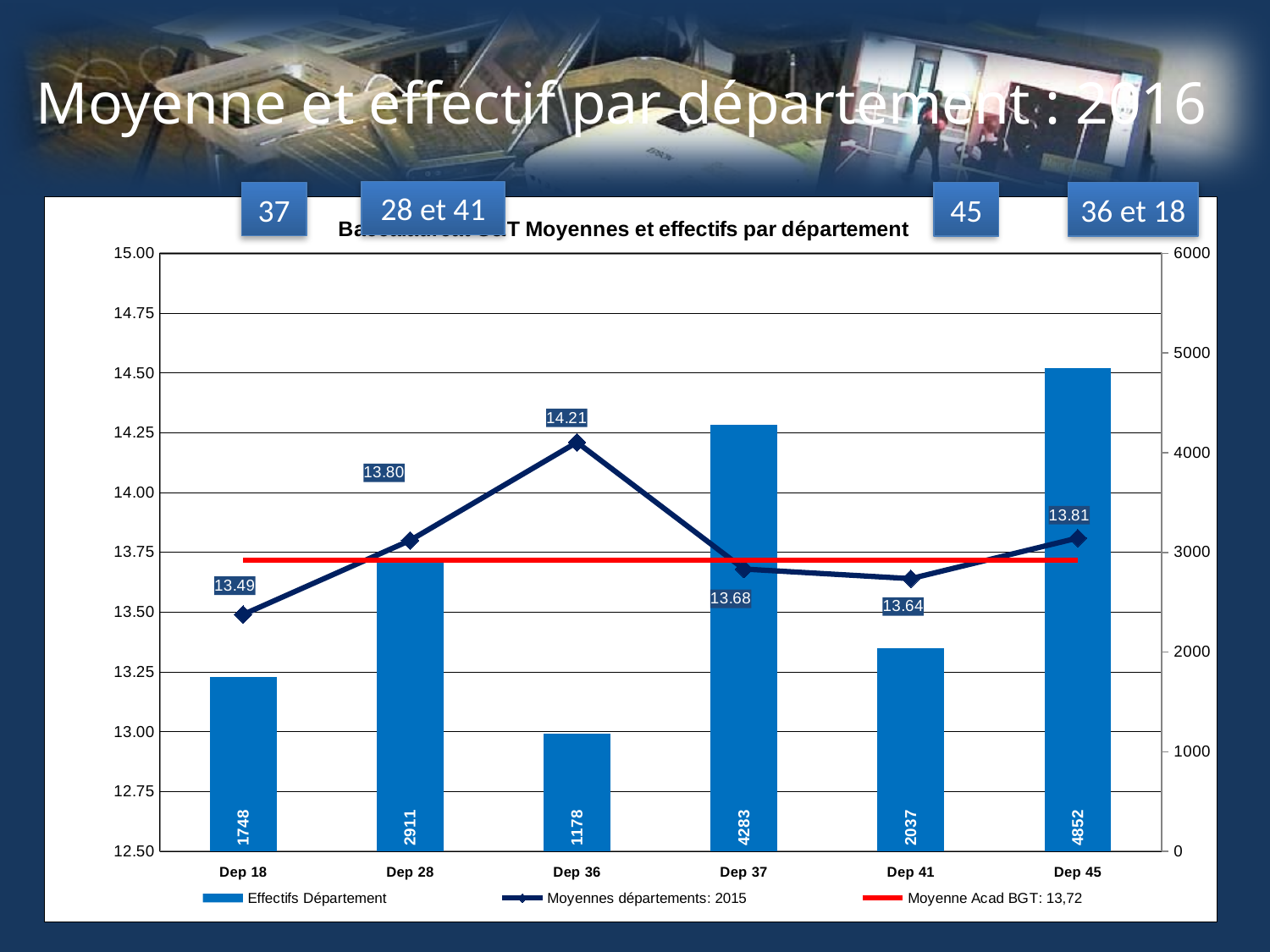
Which has a higher Moyennes départements: 2015 value, Dep 28 or Dep 45? Dep 45 Which department has the lowest Effectifs Département? Dep 36 What is the difference in Effectifs Département between Dep 37 and Dep 41? 2246 What is the Moyennes départements: 2015 value for Dep 36? 14.21 How many series does the legend list? 3 What is the value of Effectifs Département for Dep 45? 4852 What value does the legend give for Moyenne Acad BGT? 13,72 Is the Effectifs Département value for Dep 28 greater or less than 3000? less What is the Effectifs Département value for Dep 18? 1748 How many departments are shown on the x axis? 6 Which department has the lowest Moyennes départements: 2015 value? Dep 18 Which department has the highest Effectifs Département? Dep 45